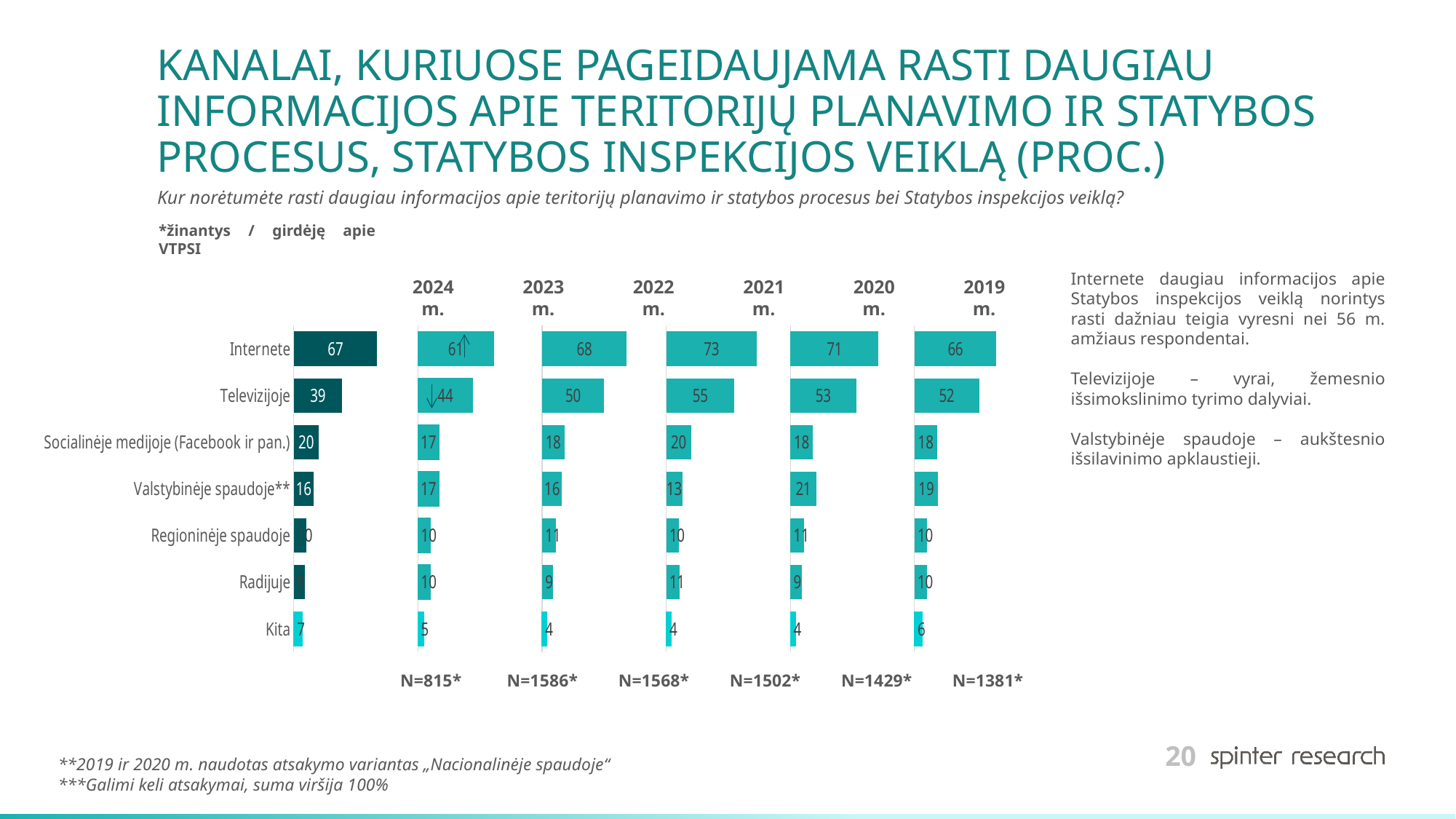
In the 2020 m. chart, which category has the lowest value? Kita In the 2024 m. chart, which is larger: the value for Socialinėje medijoje (Facebook ir pan.) or the value for Regioninėje spaudoje? Socialinėje medijoje (Facebook ir pan.) In the 2023 m. chart, which category has the highest value? Internete What type of chart is used on this slide? Bar chart In the 2024 m. chart, what is the value for Internete? 61 How many categories are shown in each of the bar charts? 7 In the 2019 m. chart, what is the value for Kita? 6 In the leftmost dark-coloured chart, what is the value for Televizijoje? 39 In the 2022 m. chart, what is the difference between the values for Internete and Televizijoje? 18 What sample size (N) is shown under the 2023 m. chart? N=1586* In the 2021 m. chart, what is the value for Valstybinėje spaudoje**? 21 In the 2022 m. chart, what is the value for Televizijoje? 55